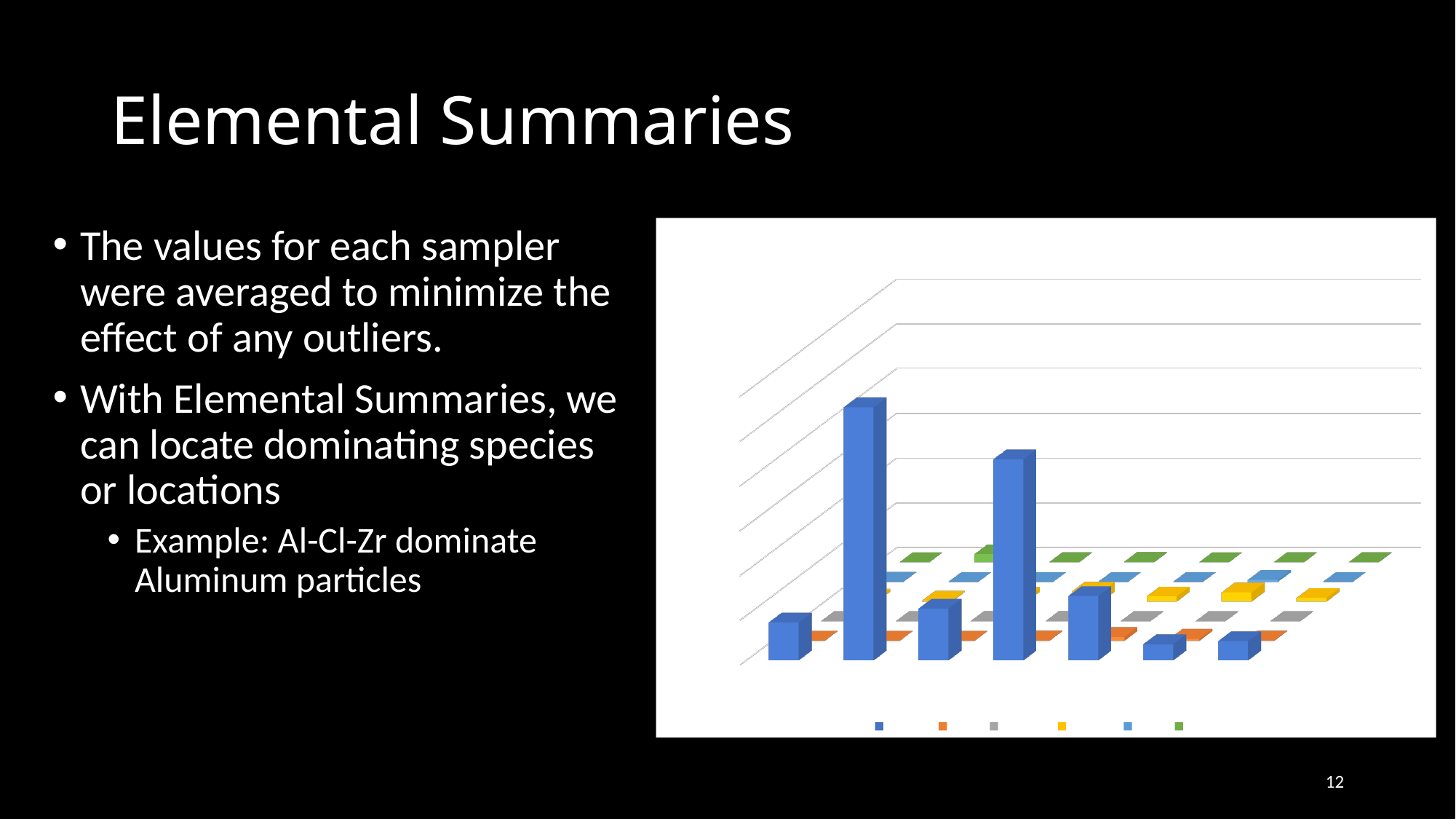
How many series does the legend of the chart show? 6 How many categories (bars in the front blue series) does the chart have? 7 Is the second blue bar from the left taller or shorter than the fourth blue bar from the left? taller Counting from the left, which blue bar in the front row is the tallest? the second What kind of chart is shown on the slide? bar chart What colour is the series plotted in the front row of the chart? blue Is the first blue bar from the left taller or shorter than the second blue bar from the left? shorter Counting from the left, which blue bar in the front row is the second tallest? the fourth Does the chart display any axis labels or data labels? No